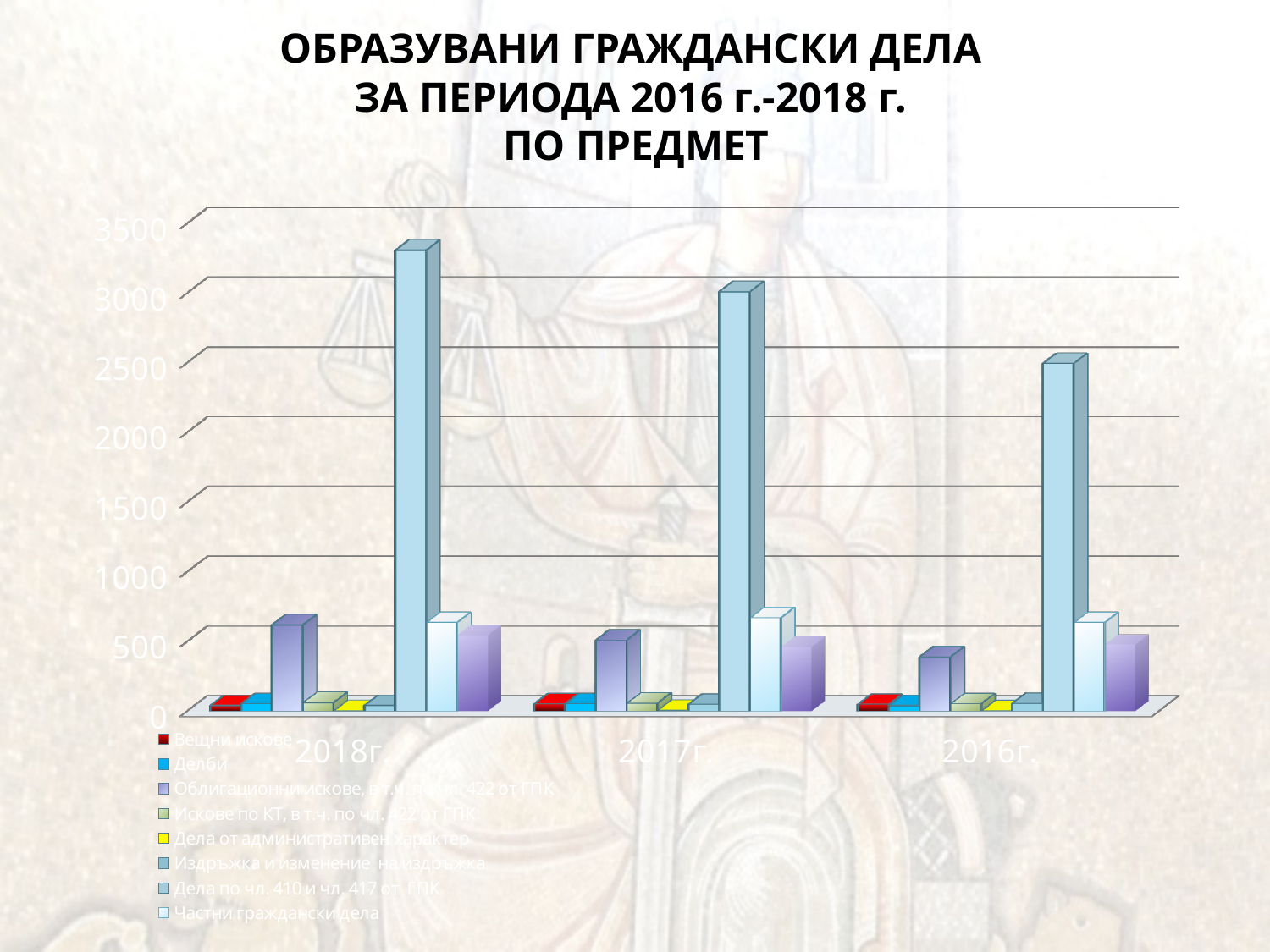
Is the tallest bar in the 2018г. group greater or less than 3000? greater Which year group has the lowest peak bar? 2016г. Is the tallest bar in the 2017г. group greater or less than 2500? greater Moving from left to right along the x axis, do the tallest bars in each group rise or fall? fall Which year group contains the highest bar on the chart? 2018г. Which year group has the taller tallest bar, 2017г. or 2016г.? 2017г. What is the title of the chart? ОБРАЗУВАНИ ГРАЖДАНСКИ ДЕЛА ЗА ПЕРИОДА 2016 г.-2018 г. ПО ПРЕДМЕТ How many year categories are shown along the x axis? 3 Is the tallest bar in the 2016г. group greater or less than 3000? less Which year group has the taller tallest bar, 2018г. or 2017г.? 2018г. What kind of chart is shown on the slide? bar chart